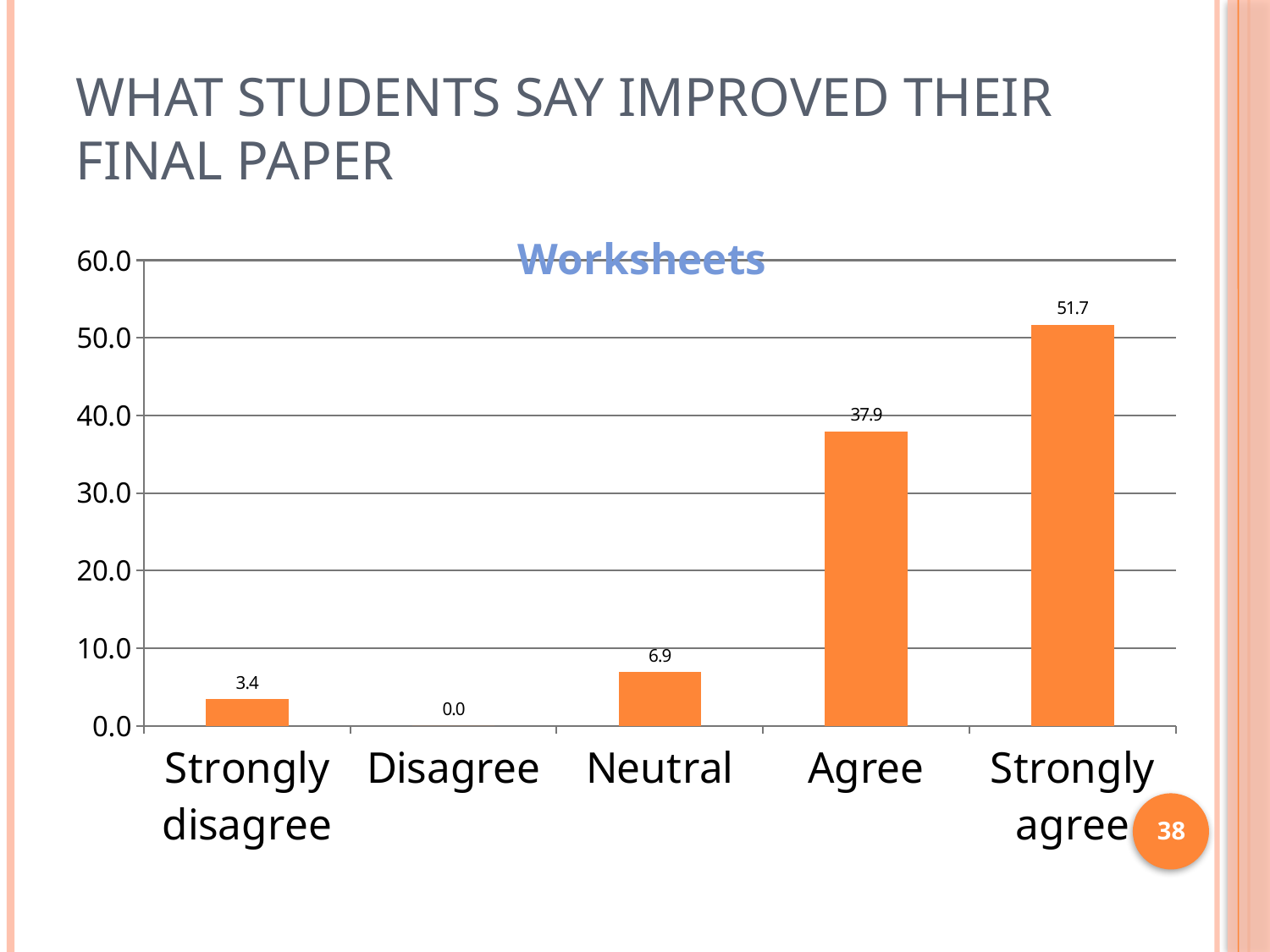
What is the value for Strongly agree? 51.7 What is the value for Disagree? 0.0 Which category has the lowest value? Disagree Which is larger, the value for Neutral or the value for Strongly disagree? Neutral How many categories are shown on the x axis? 5 What kind of chart is shown on the slide? bar chart What is the difference between the values for Strongly agree and Agree? 13.8 What is the title of the chart? Worksheets What is the value for Neutral? 6.9 Is the value for Agree greater or less than 40.0? less What is the value for Agree? 37.9 Which category has the highest value? Strongly agree